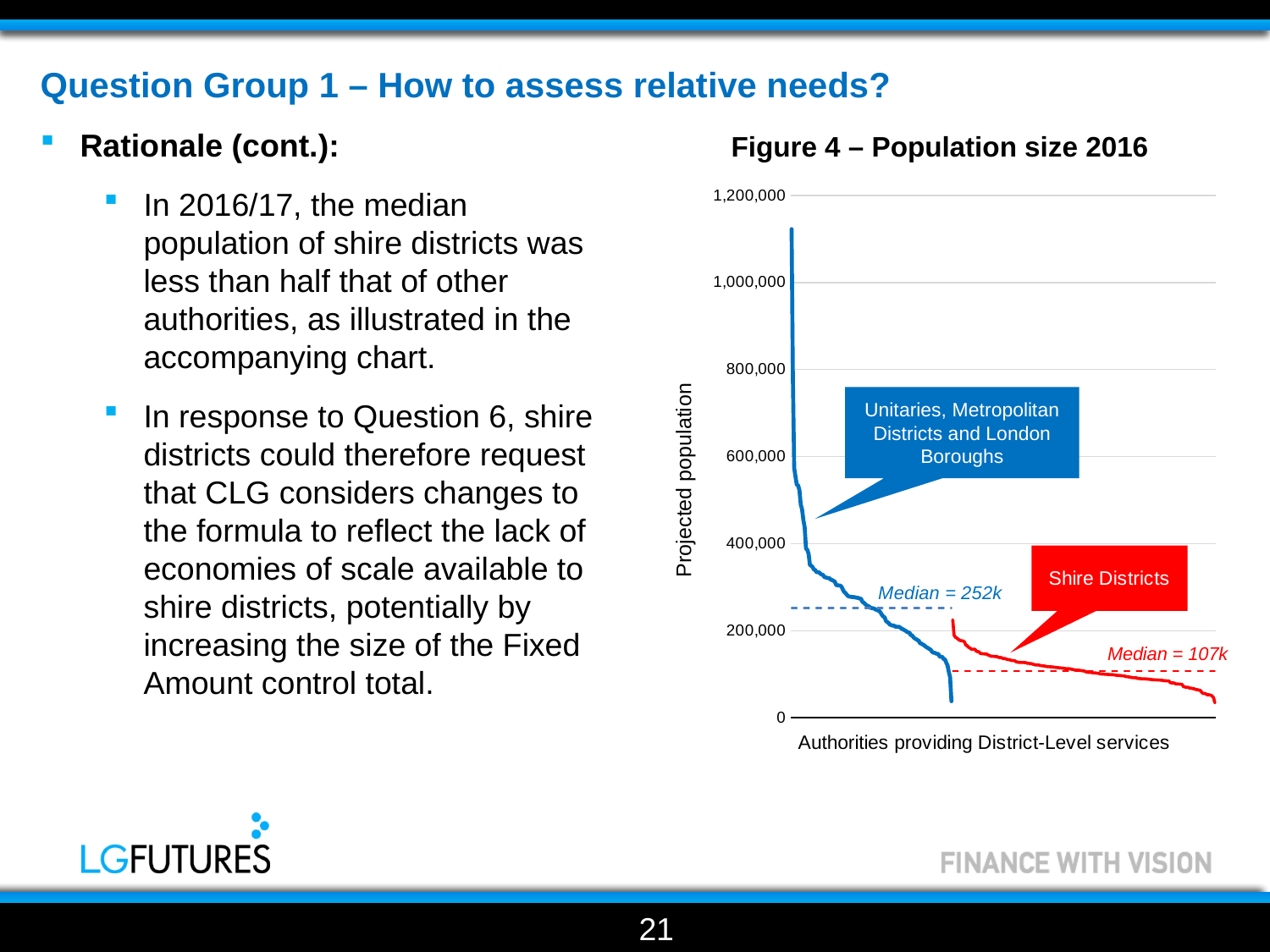
What is the label of the vertical axis of the chart? Projected population What is the title of the chart on the slide? Figure 4 – Population size 2016 What kind of chart is Figure 4 – Population size 2016? line chart How many data series are plotted in the chart? 4 What is the median population shown for Unitaries, Metropolitan Districts and London Boroughs in the chart? 252k Which group has the higher median population in the chart: Shire Districts or Unitaries, Metropolitan Districts and London Boroughs? Unitaries, Metropolitan Districts and London Boroughs Is the highest projected population in the blue series greater or less than 1,000,000? greater Is the highest projected population in the Shire Districts series greater or less than 400,000? less Is the median for Shire Districts greater or less than 200,000? less Do the projected population values rise or fall from left to right along the x axis in the chart? fall What is the median population shown for Shire Districts in the chart? 107k What is the difference between the two median values shown in the chart? 145k